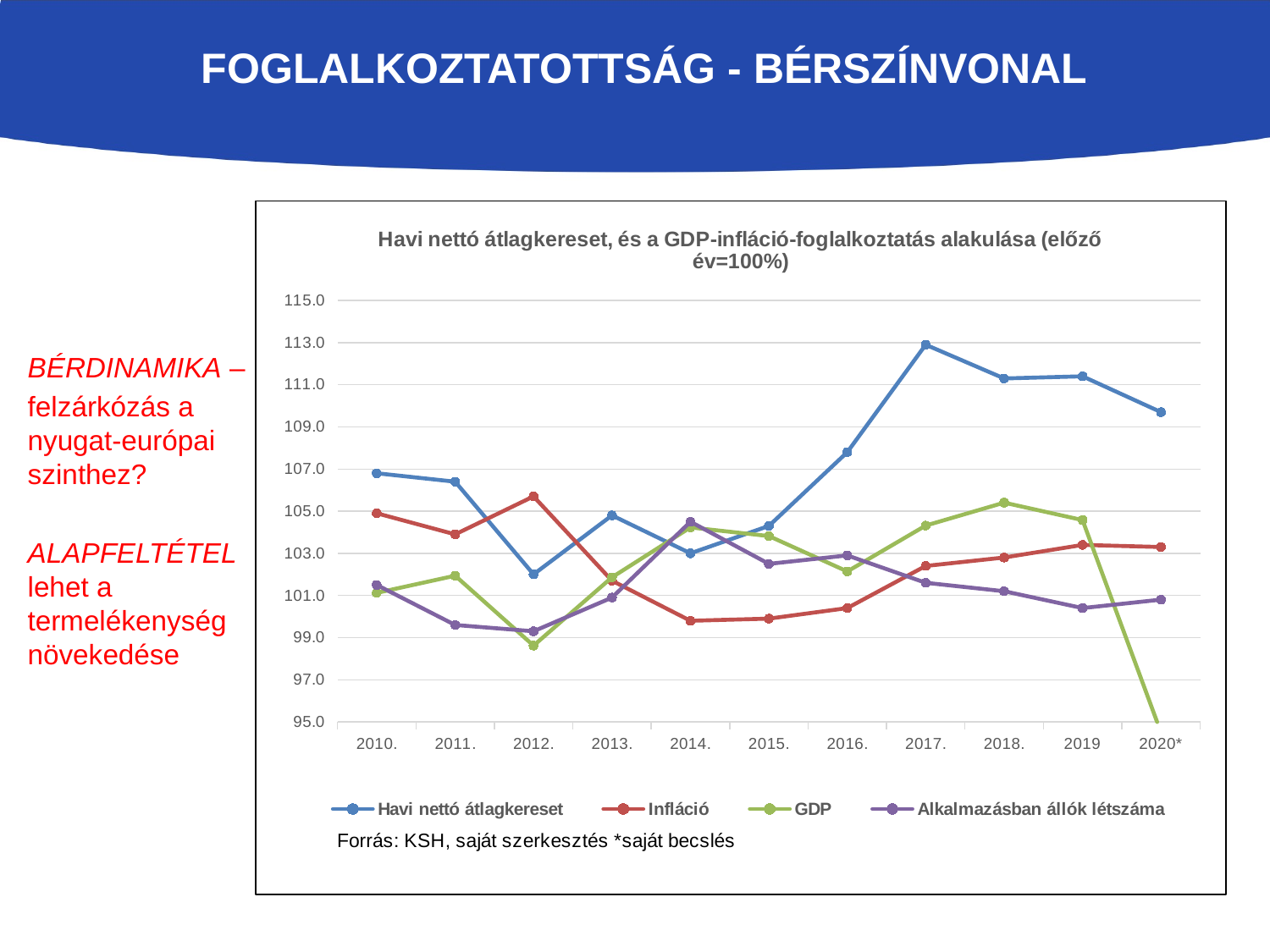
How many years are shown on the x axis? 11 Is the value for Infláció in 2012 greater or less than 105.0? greater In 2010, which is higher: Havi nettó átlagkereset or Infláció? Havi nettó átlagkereset Does the Havi nettó átlagkereset series rise or fall from 2017 to 2020*? fall Is the value for Alkalmazásban állók létszáma in 2011 greater or less than 101.0? less In which year does the GDP series reach its lowest value? 2020* In which year does the Havi nettó átlagkereset series reach its highest value? 2017. How many series does the legend list? 4 In 2018, which is higher: GDP or Infláció? GDP What colour is the GDP line in the chart? green What kind of chart is shown on the slide? line chart Is the value for Havi nettó átlagkereset in 2017 greater or less than 111.0? greater